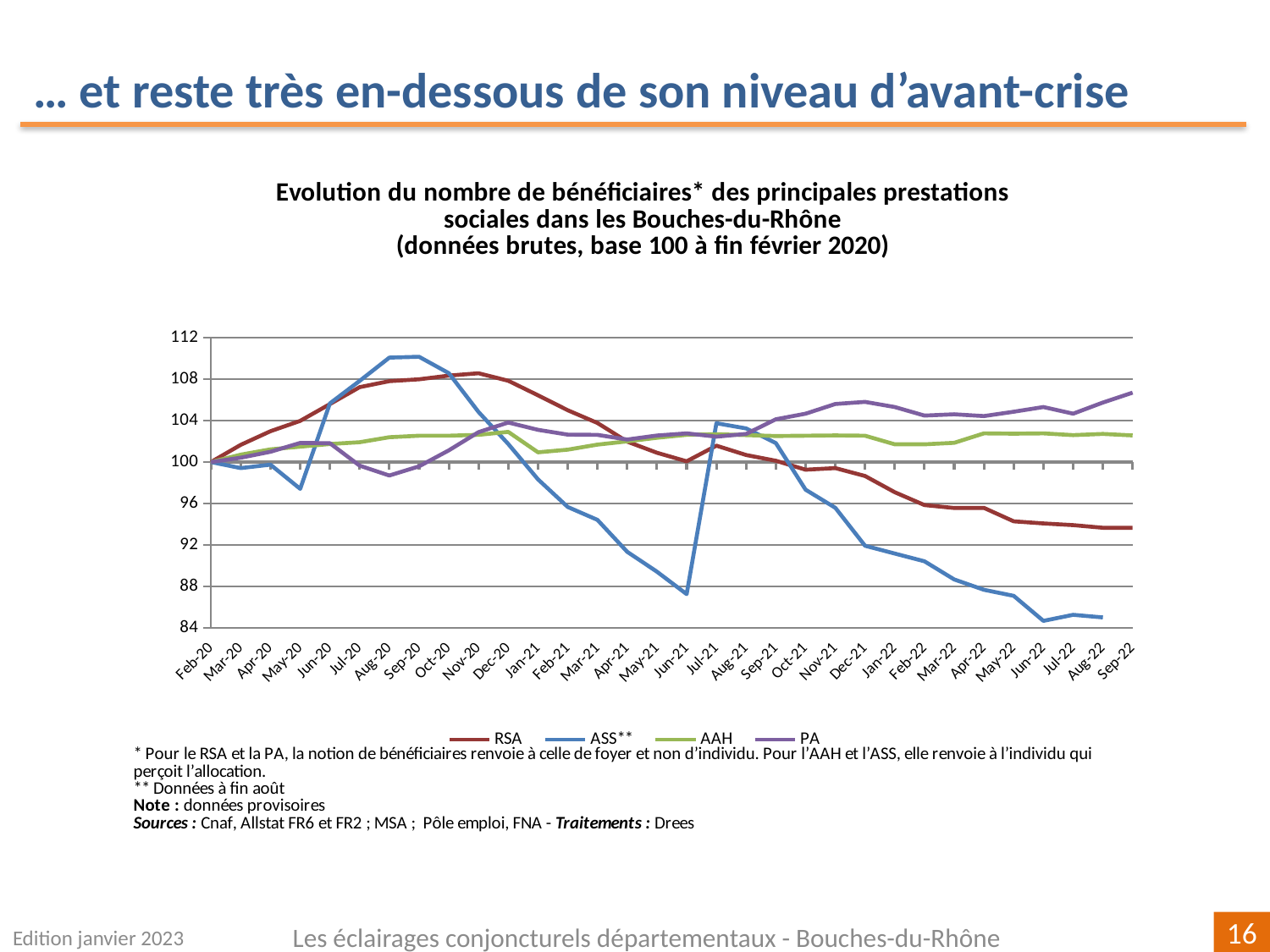
Which series are listed in the legend? RSA, ASS**, AAH, PA Is the value for ASS** in May-20 greater or less than 100? less Is the value for RSA in Sep-22 greater or less than 96? less Is the value for PA in Sep-22 greater or less than 104? greater Which series has the highest value in Sep-22? PA What kind of chart is shown on the slide? line chart Does the RSA series rise or fall between Nov-20 and Sep-22? fall Which series has the lowest value in Aug-22? ASS** How many series does the legend list? 4 What is the base period for the index (base 100) according to the chart title? fin février 2020